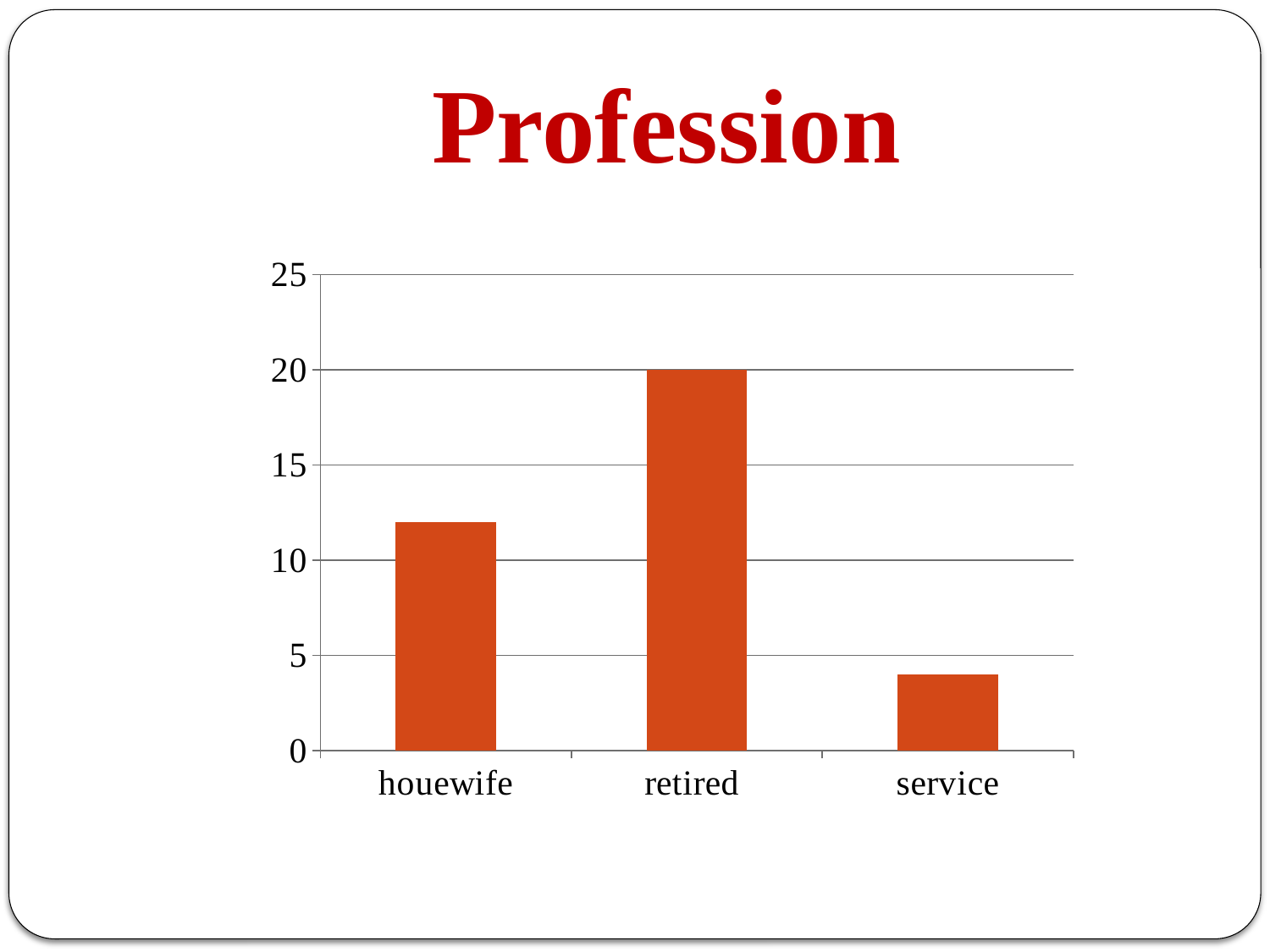
Which is larger, the value for retired or the value for houewife? retired Which category has the lowest value? service What is the title of the chart? Profession Is the value for service greater or less than 5? less What is the highest value shown on the y axis? 25 Is the value for houewife greater or less than 10? greater How many categories are shown on the x axis? 3 What kind of chart is shown on the slide? bar chart Is the value for houewife greater or less than 15? less Which is larger, the value for houewife or the value for service? houewife Which category has the highest value? retired What is the value for retired? 20